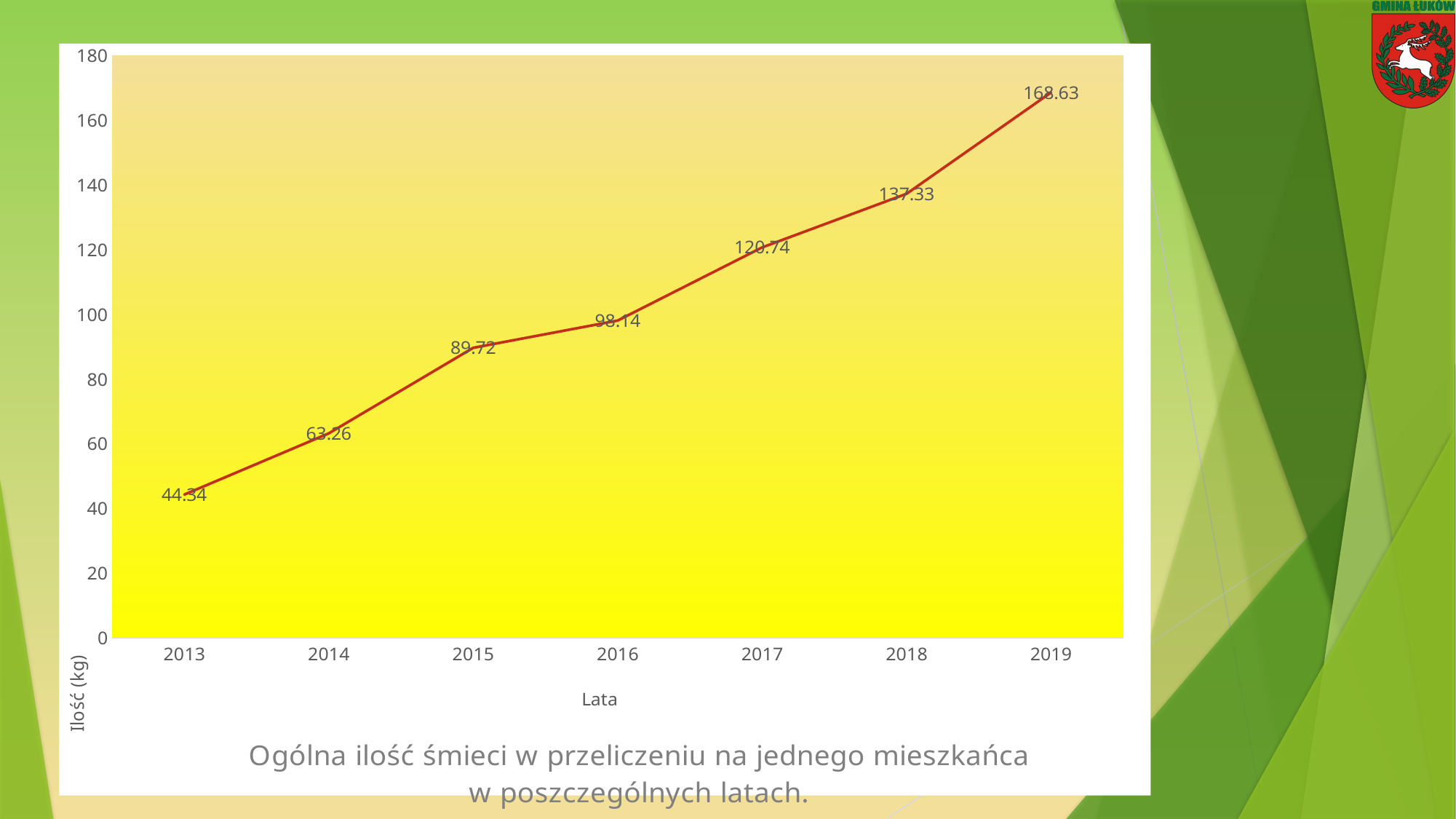
What is the value for 2017? 120.74 What is the difference between the values for 2015 and 2014? 26.46 Which year has the lowest value? 2013 What is the difference between the values for 2019 and 2013? 124.29 What is the value for 2013? 44.34 Is the value for 2015 greater or less than 80? greater How many years are plotted on the chart? 7 What is the value for 2019? 168.63 What kind of chart is shown on the slide? line chart Do the values rise or fall from 2013 to 2019? rise Which is larger, the value for 2016 or the value for 2018? 2018 Which year has the highest value? 2019